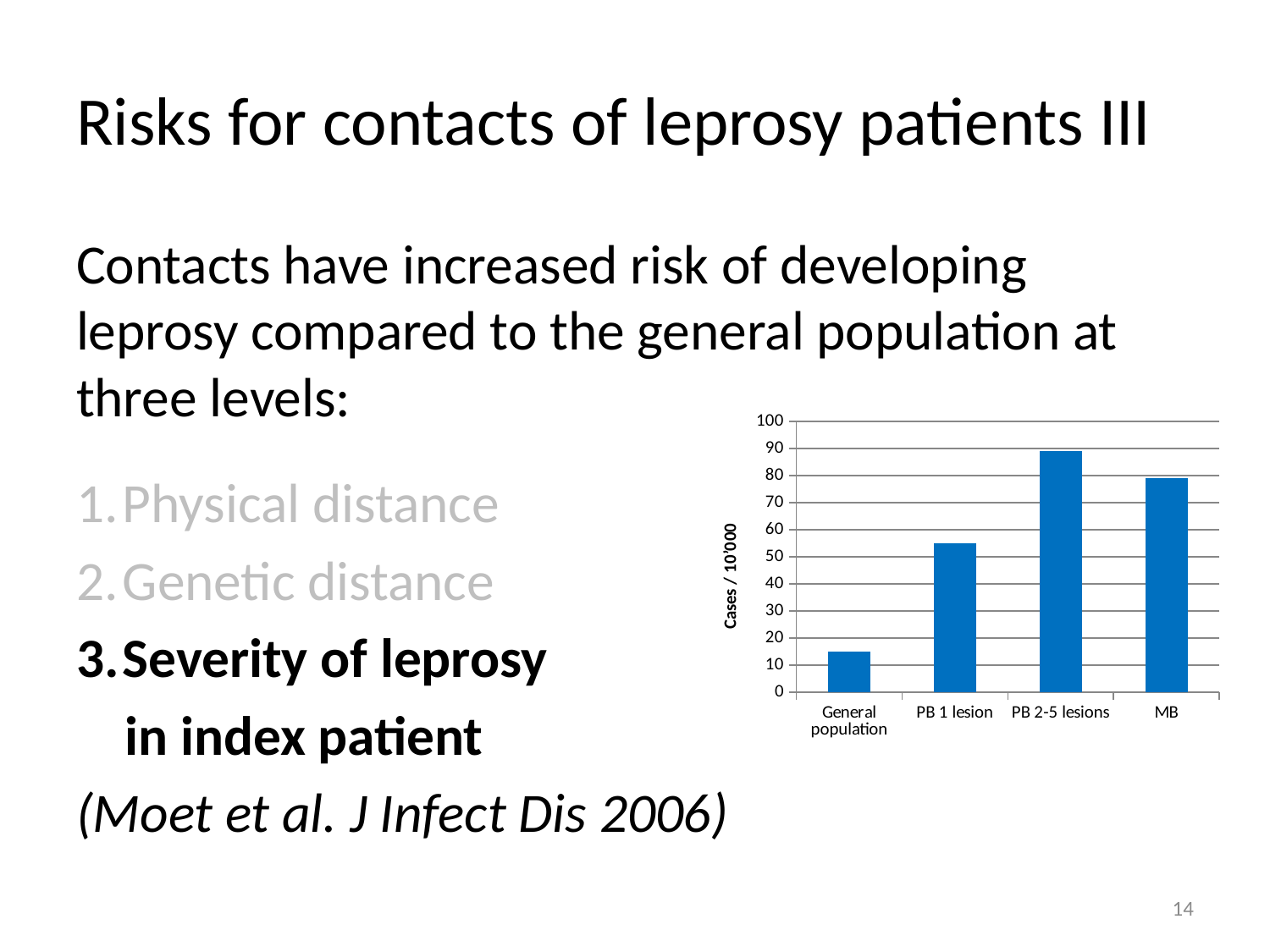
Which category has the lowest value in the chart? General population Which is larger, the value for PB 1 lesion or the value for MB? MB What is the maximum value shown on the vertical axis of the chart? 100 Is the value for MB greater or less than 90? less What is the label of the vertical axis of the chart? Cases / 10'000 Which is larger, the value for PB 2-5 lesions or the value for MB? PB 2-5 lesions Is the value for General population greater or less than 20? less Is the value for PB 1 lesion greater or less than 50? greater How many categories are shown on the x axis of the chart? 4 Which category has the highest value in the chart? PB 2-5 lesions What kind of chart is shown on the slide? bar chart